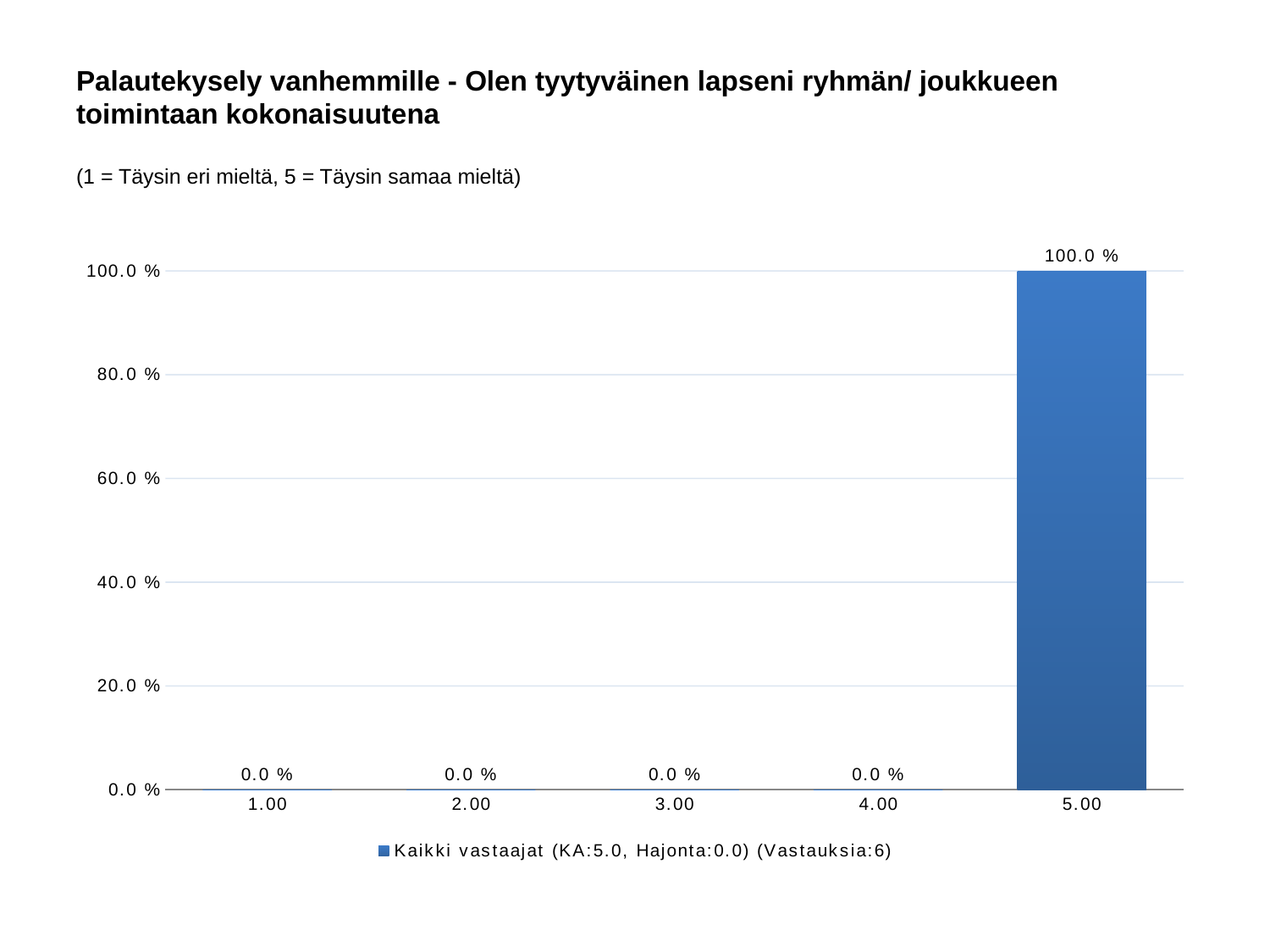
How many series does the legend list? 1 How many responses (Vastauksia) does the legend report? 6 What is the value for category 1.00? 0.0 % Which is larger, the value for 2.00 or the value for 5.00? 5.00 How many categories are shown on the x axis? 5 What kind of chart is shown? bar chart What is the difference between the values for 5.00 and 4.00? 100.0 % What is the value for category 3.00? 0.0 % What is the legend entry for the series? Kaikki vastaajat (KA:5.0, Hajonta:0.0) (Vastauksia:6) Which category has the highest value? 5.00 What is the value for category 5.00? 100.0 % Is the value for 5.00 greater or less than 80.0 %? greater